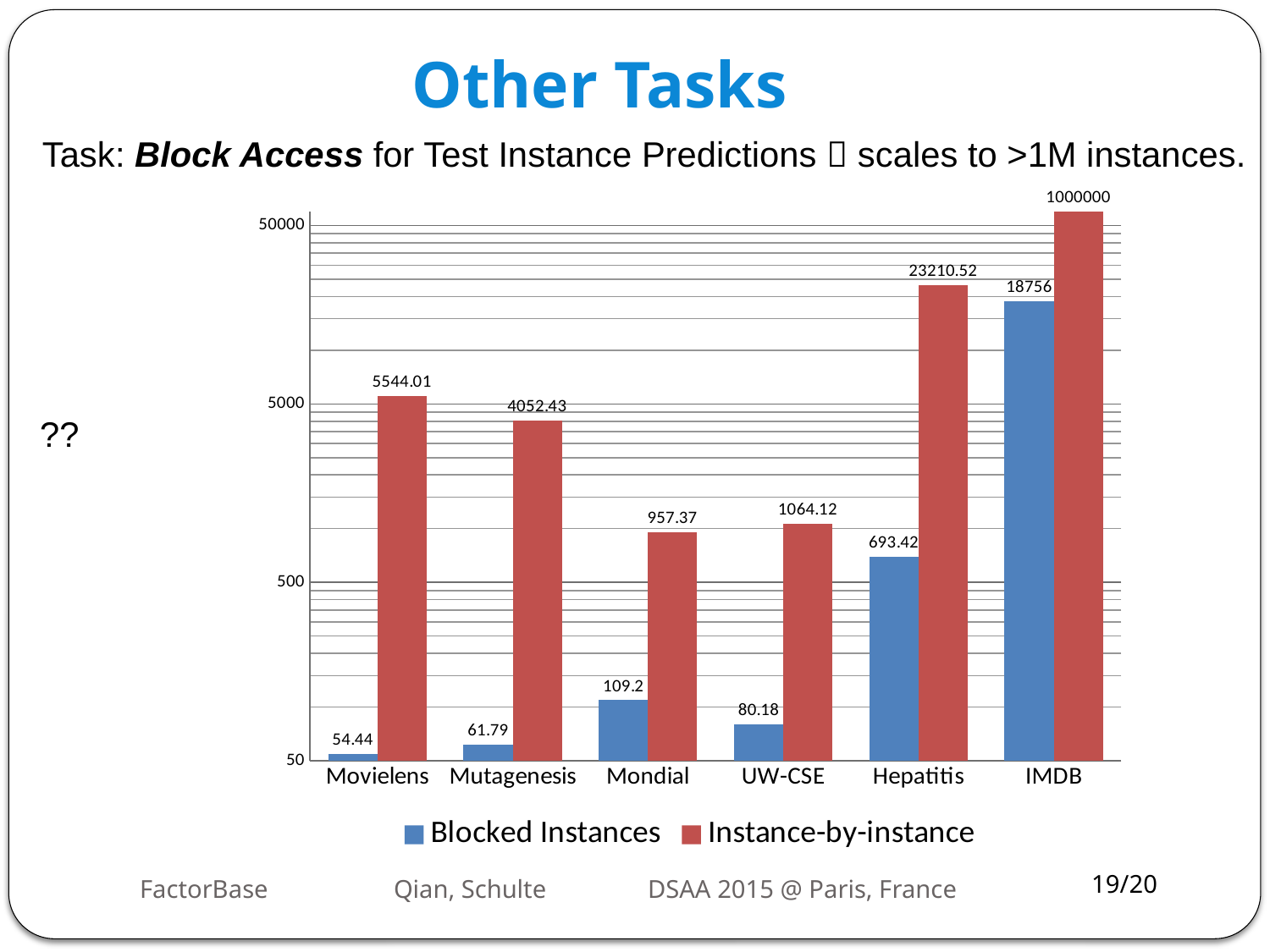
What is the difference between the Instance-by-instance and Blocked Instances values for UW-CSE? 983.94 What is the Instance-by-instance value for IMDB? 1000000 Which category has the lowest Instance-by-instance value? Mondial What kind of chart is shown on the slide? bar chart Which category has the highest Blocked Instances value? IMDB Is the Blocked Instances value for Hepatitis greater or less than 500? greater What is the Instance-by-instance value for Hepatitis? 23210.52 How many series does the legend list? 2 How many categories are shown on the x axis? 6 What is the Blocked Instances value for Mondial? 109.2 What is the Blocked Instances value for Movielens? 54.44 Which is larger, the Instance-by-instance value for Movielens or for Mutagenesis? Movielens